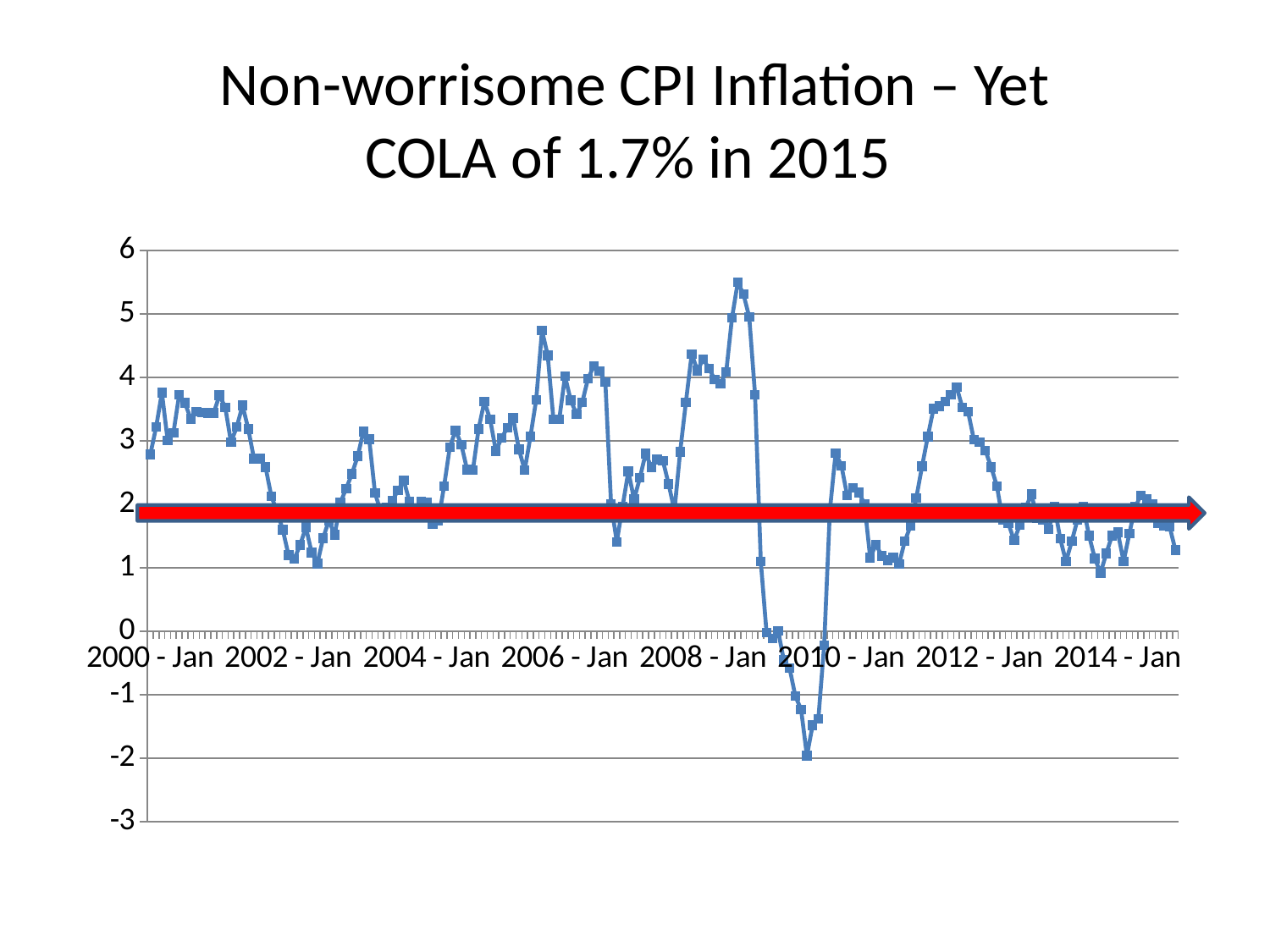
What is the lowest value shown on the vertical axis of the chart? -3 Is the lowest point on the line greater or less than -1? less In which year does the line reach its lowest point? 2009 What is the title of the slide containing the chart? Non-worrisome CPI Inflation – Yet COLA of 1.7% in 2015 Is the highest point on the line greater or less than 5? greater Which is larger, the value at 2000 - Jan or the value at 2002 - Jan? 2000 - Jan What kind of chart is shown on the slide? line chart In which year does the line reach its highest point? 2008 What is the highest value shown on the vertical axis of the chart? 6 Is the value at 2000 - Jan greater or less than 2? greater How many year labels are shown along the horizontal axis? 8